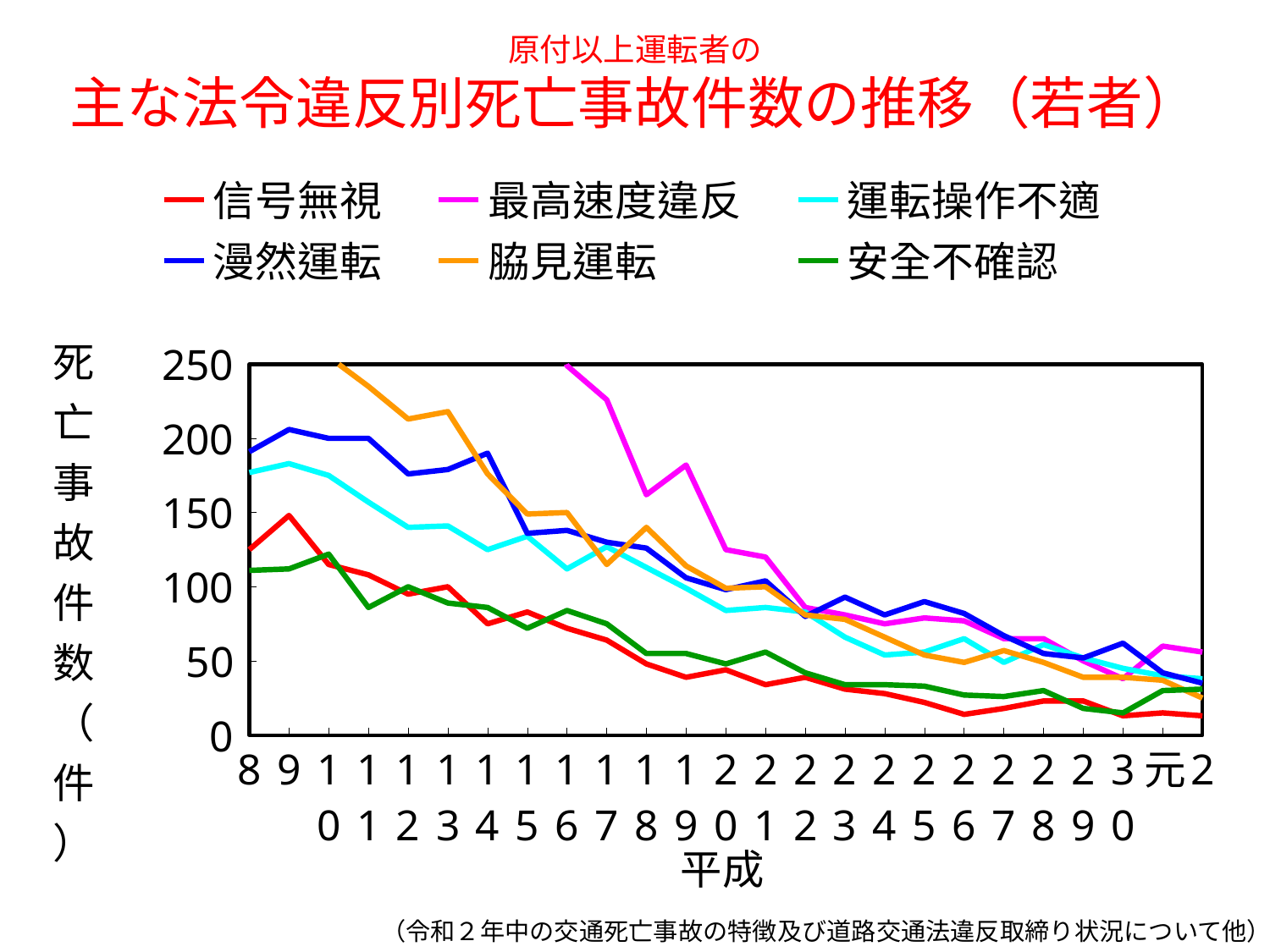
Is the value for 漫然運転 in 平成9 greater or less than 200? greater Do the values for 信号無視 generally rise or fall from 平成9 to 令和2? fall What kind of chart is shown on the slide? line chart Is the value for 最高速度違反 in 平成17 greater or less than 200? greater Which colour is used for the 脇見運転 series? orange What is the label of the y axis? 死亡事故件数（件） How many series does the legend list? 6 Is the value for 安全不確認 in 平成8 greater or less than 100? greater How many points along the x axis does the chart cover (from 平成8 to 令和2)? 25